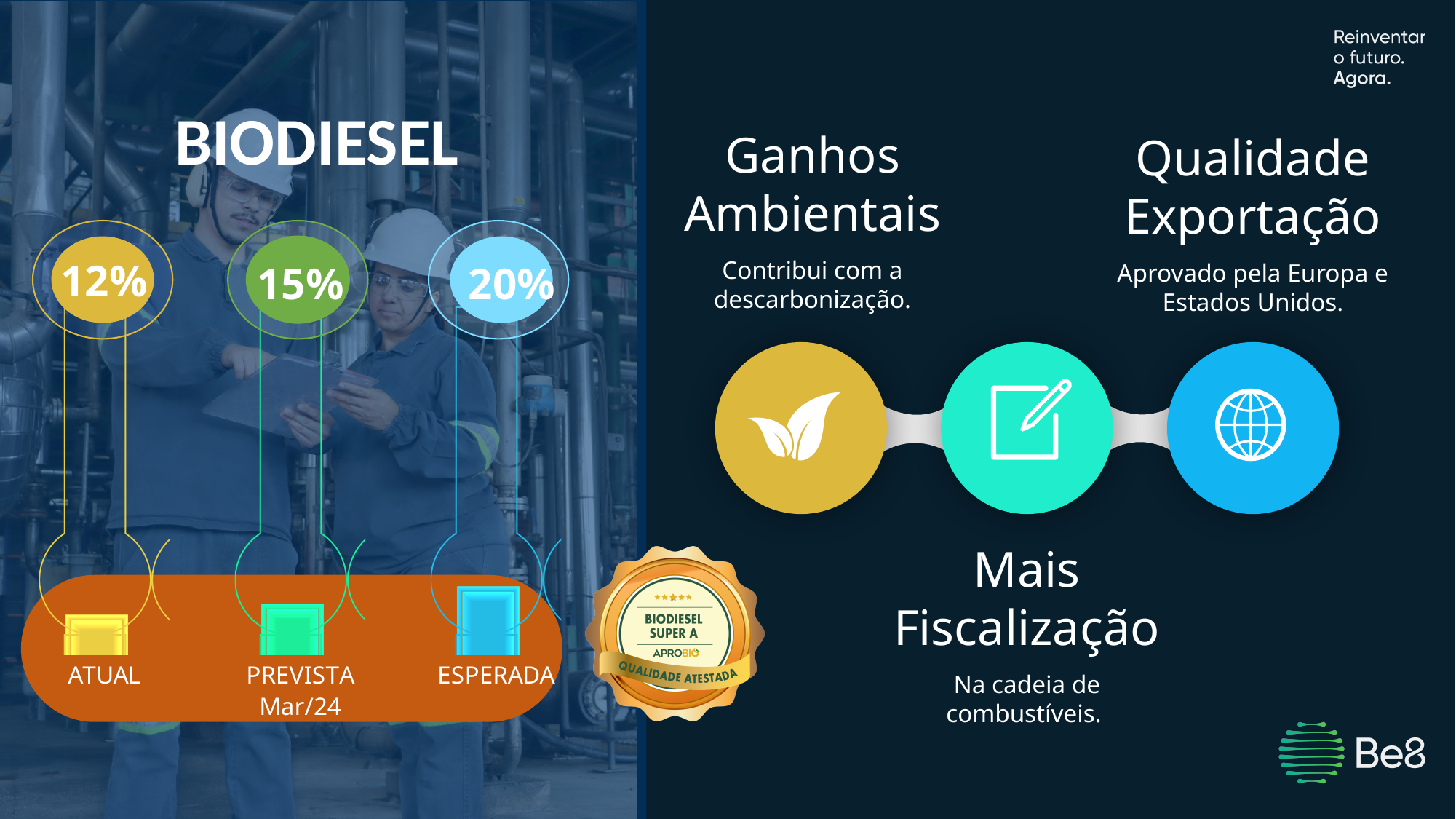
In the BIODIESEL infographic, which is larger, the PREVISTA Mar/24 value or the ESPERADA value? ESPERADA In the BIODIESEL infographic, what is the difference between the PREVISTA Mar/24 and ATUAL percentages? 3% In the BIODIESEL infographic, what is the percentage shown for PREVISTA Mar/24? 15% How many stages are shown in the BIODIESEL infographic? 3 In the BIODIESEL infographic, what is the difference between the ESPERADA and ATUAL percentages? 8% In the BIODIESEL infographic, what is the percentage shown for ESPERADA? 20% In the BIODIESEL infographic, do the percentages rise or fall from ATUAL to ESPERADA? rise In the BIODIESEL infographic, what date is given for the PREVISTA stage? Mar/24 In the BIODIESEL infographic, which stage has the lowest percentage? ATUAL In the BIODIESEL infographic, which stage has the highest percentage? ESPERADA In the BIODIESEL infographic, what colour is the circle showing 15%? green In the BIODIESEL infographic, what is the percentage shown for ATUAL? 12%